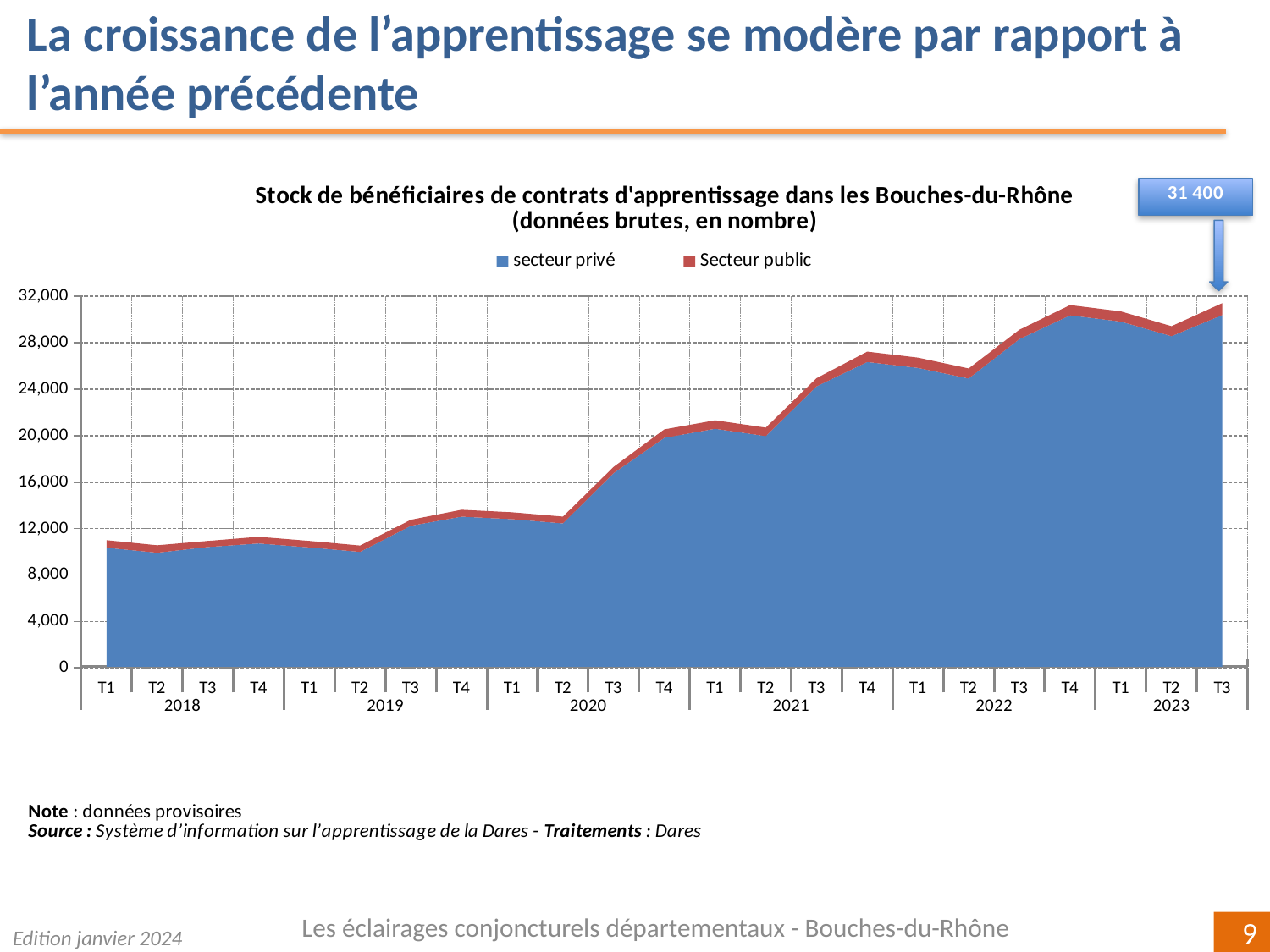
What kind of chart is shown on the slide? area chart What is the total stock of apprenticeship contract beneficiaries at T3 2023, as shown by the callout? 31 400 Which is larger, the total value for T4 2021 or for T2 2022? T4 2021 How many series does the legend list? 2 Is the total value for T1 2018 greater or less than 8,000? greater Which series is shown in blue? secteur privé Which series is shown in red? Secteur public Is the total value for T2 2019 greater or less than 12,000? less Is the total value for T4 2021 greater or less than 24,000? greater Overall, do the values rise or fall from T1 2018 to T3 2023? rise How many quarters are plotted along the x axis? 23